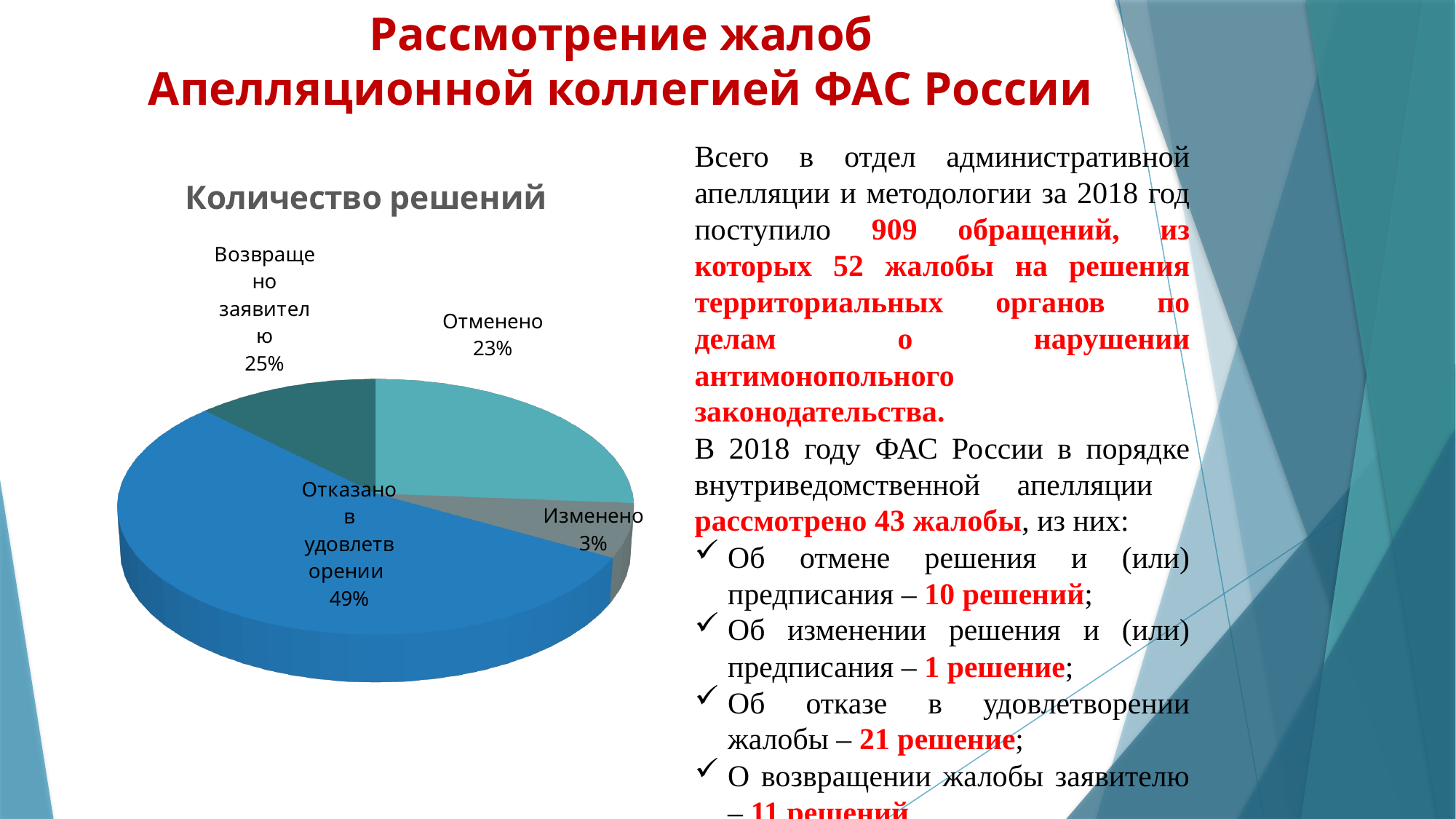
What is the title of the chart on the slide? Количество решений Which is larger: the share for "Возвращено заявителю" or the share for "Отменено"? Возвращено заявителю Which category has the largest slice of the pie? Отказано в удовлетворении What type of chart is shown under the title "Количество решений"? Pie chart What is the combined share of "Отменено" and "Изменено"? 26% How many slices does the pie chart have? 4 What share of the pie does "Отказано в удовлетворении" take? 49% Which category has the smallest slice of the pie? Изменено What share of the pie does "Возвращено заявителю" take? 25% What is the difference in percentage points between "Отказано в удовлетворении" and "Отменено"? 26 What share of the pie does "Отменено" take? 23% What share of the pie does "Изменено" take? 3%